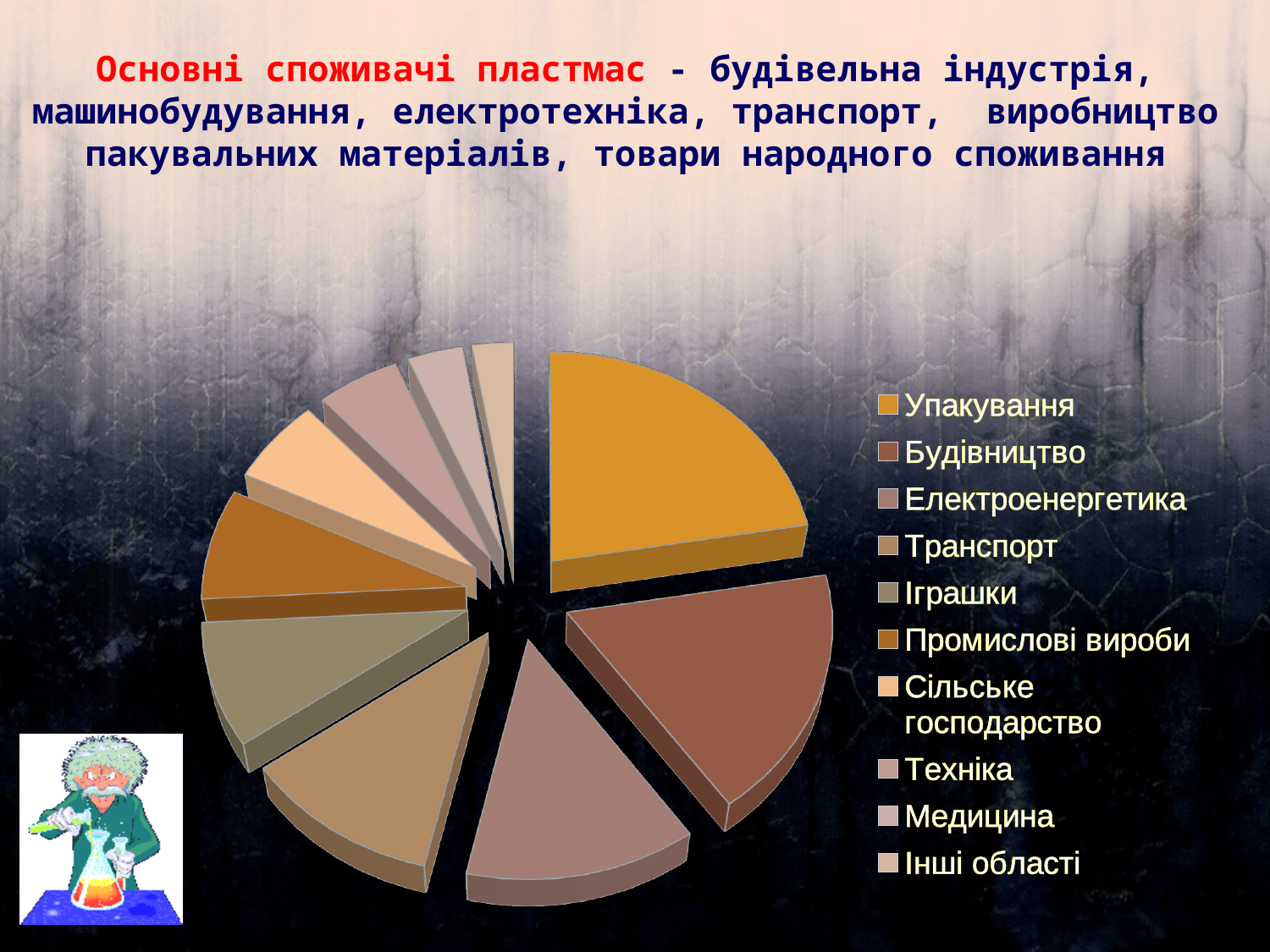
Which slice is larger, Упакування or Будівництво? Упакування How many entries does the legend of the pie chart list? 10 What is the first entry listed in the legend of the pie chart? Упакування On which side of the pie chart is the legend placed? Right What kind of chart is shown on the slide? Pie chart Which slice is larger, Упакування or Інші області? Упакування Which slice is larger, Будівництво or Медицина? Будівництво Which category has the smallest slice of the pie chart? Інші області How many categories (slices) does the pie chart have? 10 Which category has the largest slice of the pie chart? Упакування